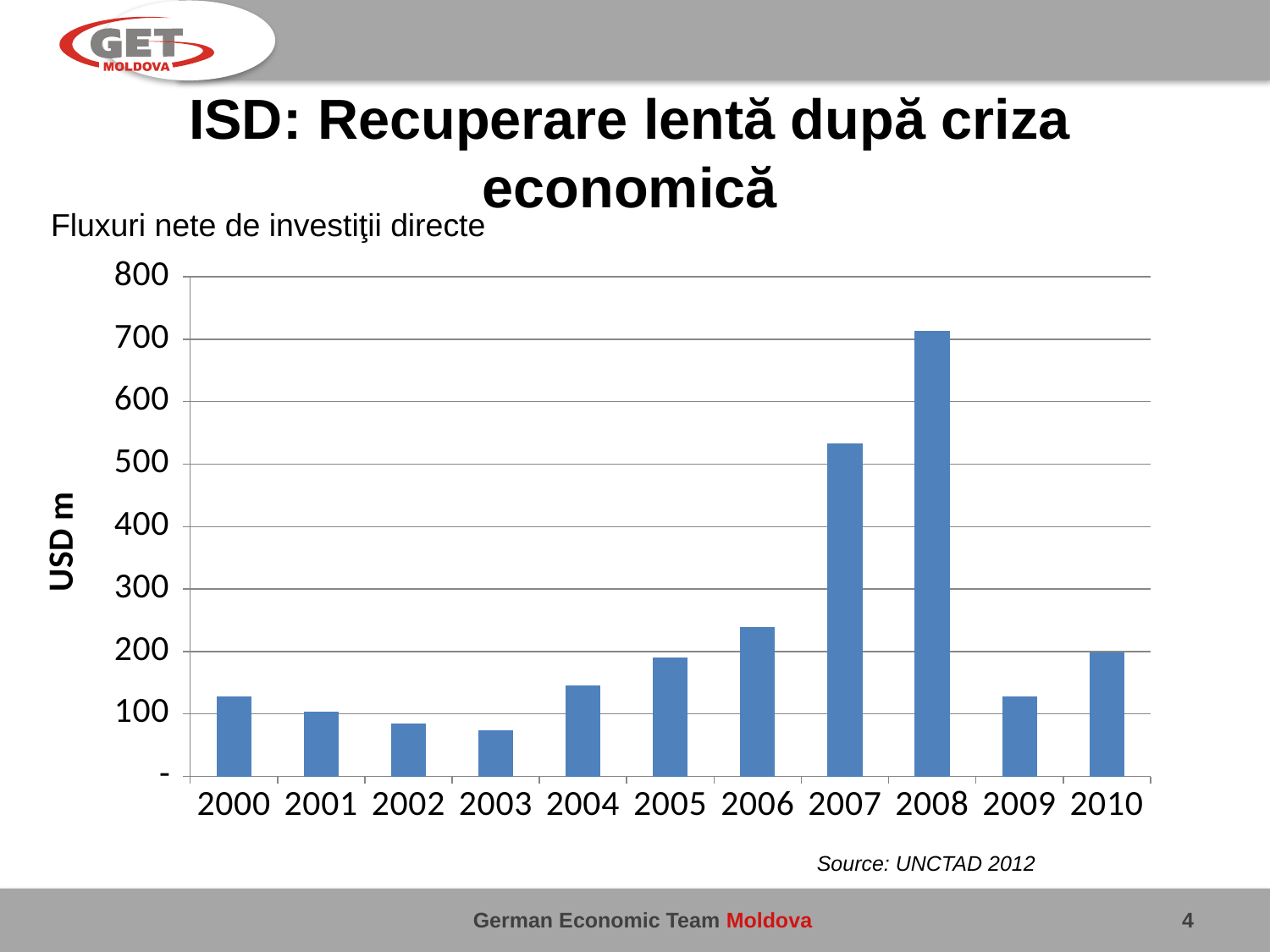
How many years are shown on the x axis of the chart? 11 Which year has the highest net direct investment flow? 2008 Is the value for 2007 greater or less than 500? greater Do the values rise or fall from 2003 to 2008? rise Is the value for 2008 greater or less than 600? greater Is the value for 2006 greater or less than 200? greater Which year has the larger value, 2007 or 2008? 2008 What kind of chart is shown on the slide? bar chart What is the label on the vertical axis of the chart? USD m Which year has the lowest net direct investment flow? 2003 Which year has the larger value, 2004 or 2005? 2005